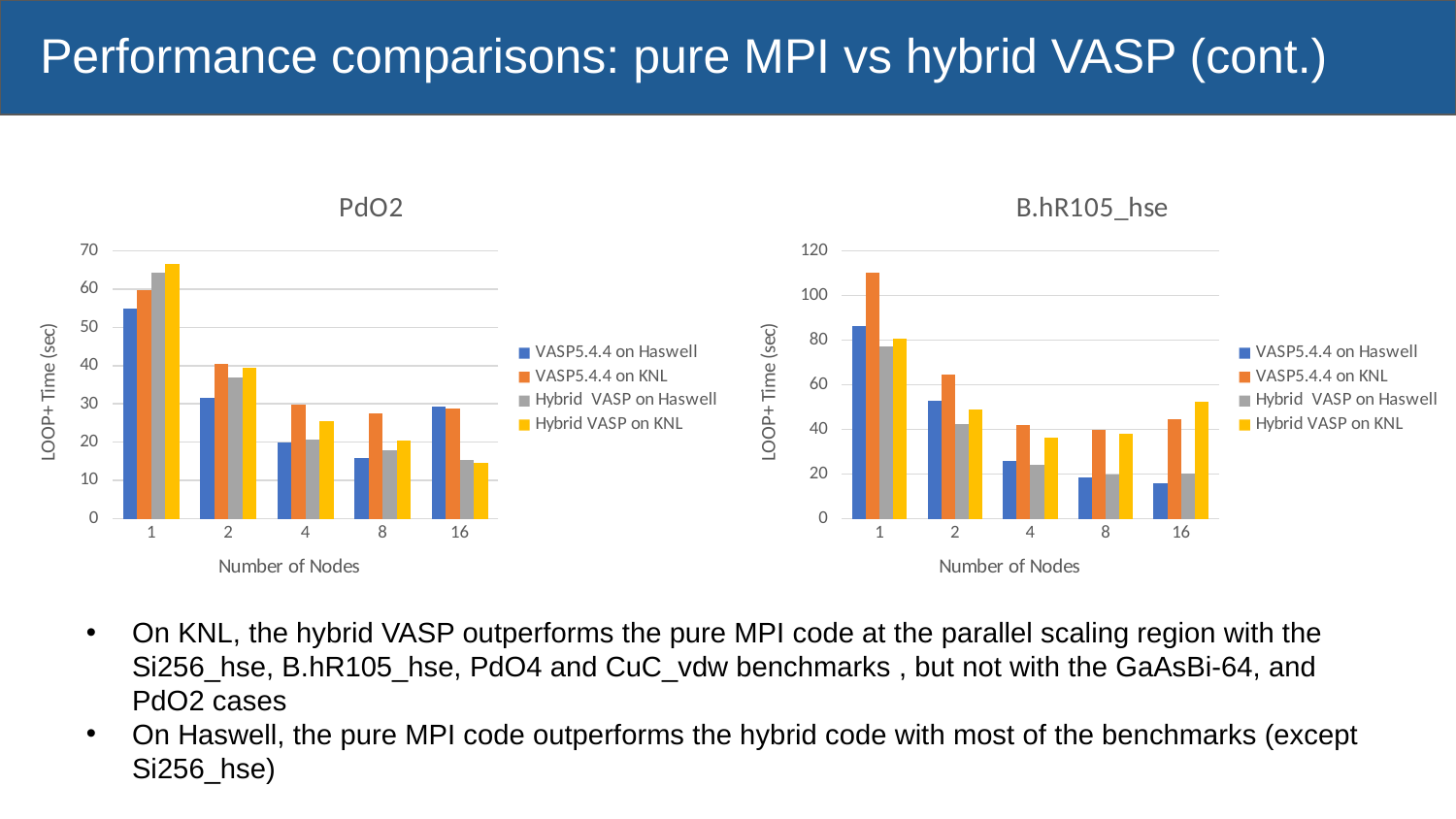
In the B.hR105_hse chart at 16 nodes, which is larger: Hybrid VASP on KNL or VASP5.4.4 on Haswell? Hybrid VASP on KNL In the B.hR105_hse chart, which series has the highest LOOP+ time at 1 node? VASP5.4.4 on KNL How many series does the legend of the B.hR105_hse chart list? 4 What is the x-axis title of the PdO2 chart? Number of Nodes In the B.hR105_hse chart, is the value for VASP5.4.4 on KNL at 1 node greater or less than 100? greater What kind of chart is the PdO2 chart? bar chart How many node counts are shown on the x axis of the PdO2 chart? 5 In the PdO2 chart, is the value for VASP5.4.4 on KNL at 1 node greater or less than 50? greater What is the y-axis title of the B.hR105_hse chart? LOOP+ Time (sec) In the B.hR105_hse chart, does the LOOP+ time for VASP5.4.4 on Haswell rise or fall as the number of nodes increases from 1 to 16? fall In the PdO2 chart, which series has the highest LOOP+ time at 8 nodes? VASP5.4.4 on KNL In the PdO2 chart, is the value for Hybrid VASP on KNL at 16 nodes greater or less than 20? less